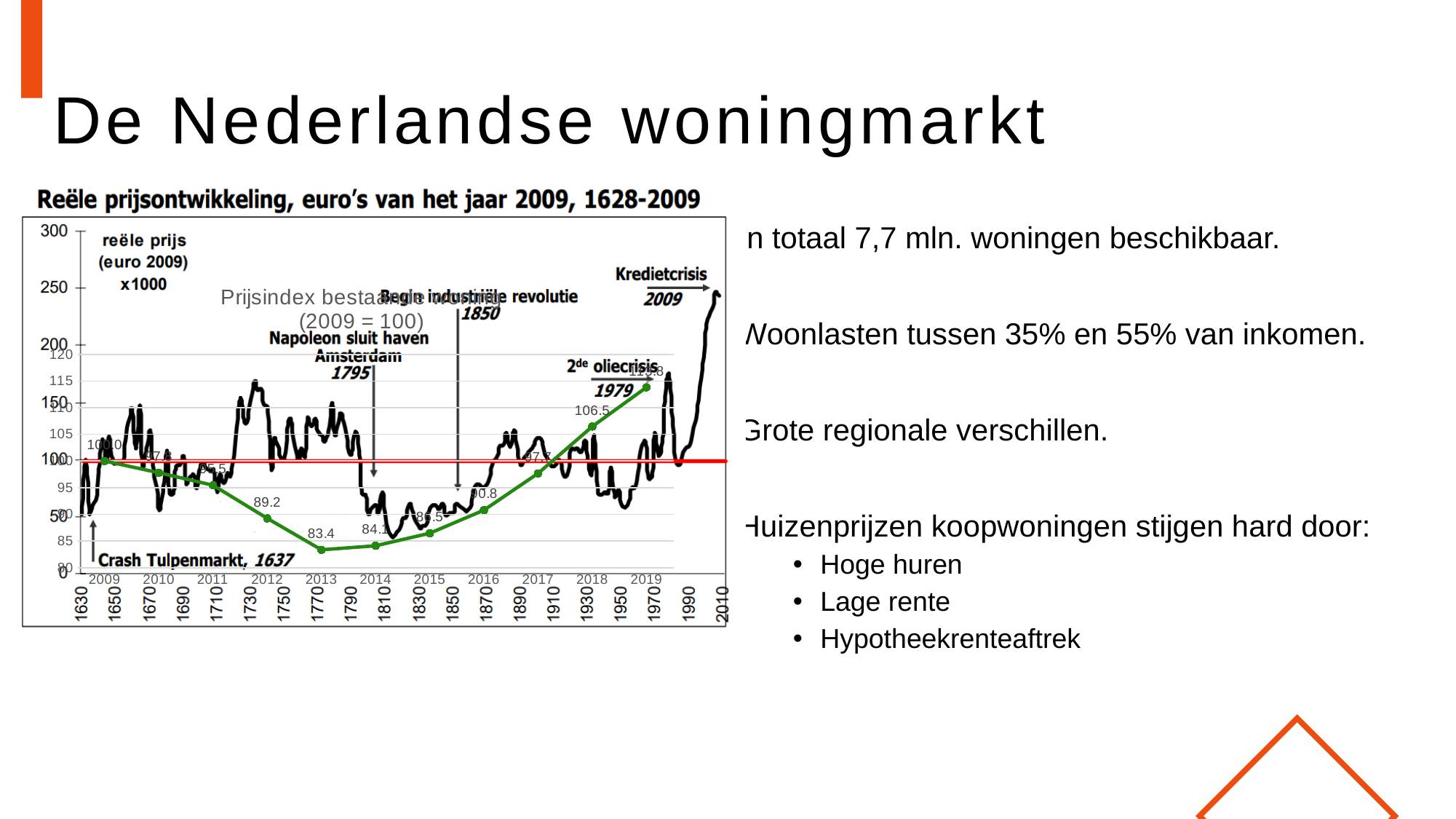
In the 'Prijsindex bestaande woning' chart, is the value for 2019 greater or less than 110? greater How many yearly data points does the 'Prijsindex bestaande woning' line chart show? 11 In the 'Prijsindex bestaande woning' chart, what is the index value for 2018? 106.5 In the 'Prijsindex bestaande woning' chart, which year has the highest index value? 2019 In the 'Prijsindex bestaande woning' chart, what is the index value for 2012? 89.2 In the 'Prijsindex bestaande woning' chart, which year has the lowest index value? 2013 In the 'Prijsindex bestaande woning' chart, what is the difference between the 2018 value and the 2017 value? 8.8 In the 'Prijsindex bestaande woning' chart, what is the index value for 2009? 100.0 In the 'Prijsindex bestaande woning' chart, which year has the higher index value, 2012 or 2016? 2016 What kind of chart is the green 'Prijsindex bestaande woning (2009 = 100)' chart? line chart In the 'Prijsindex bestaande woning' chart, does the index rise or fall from 2013 to 2019? rise In the 'Prijsindex bestaande woning' chart, what is the index value for 2013? 83.4